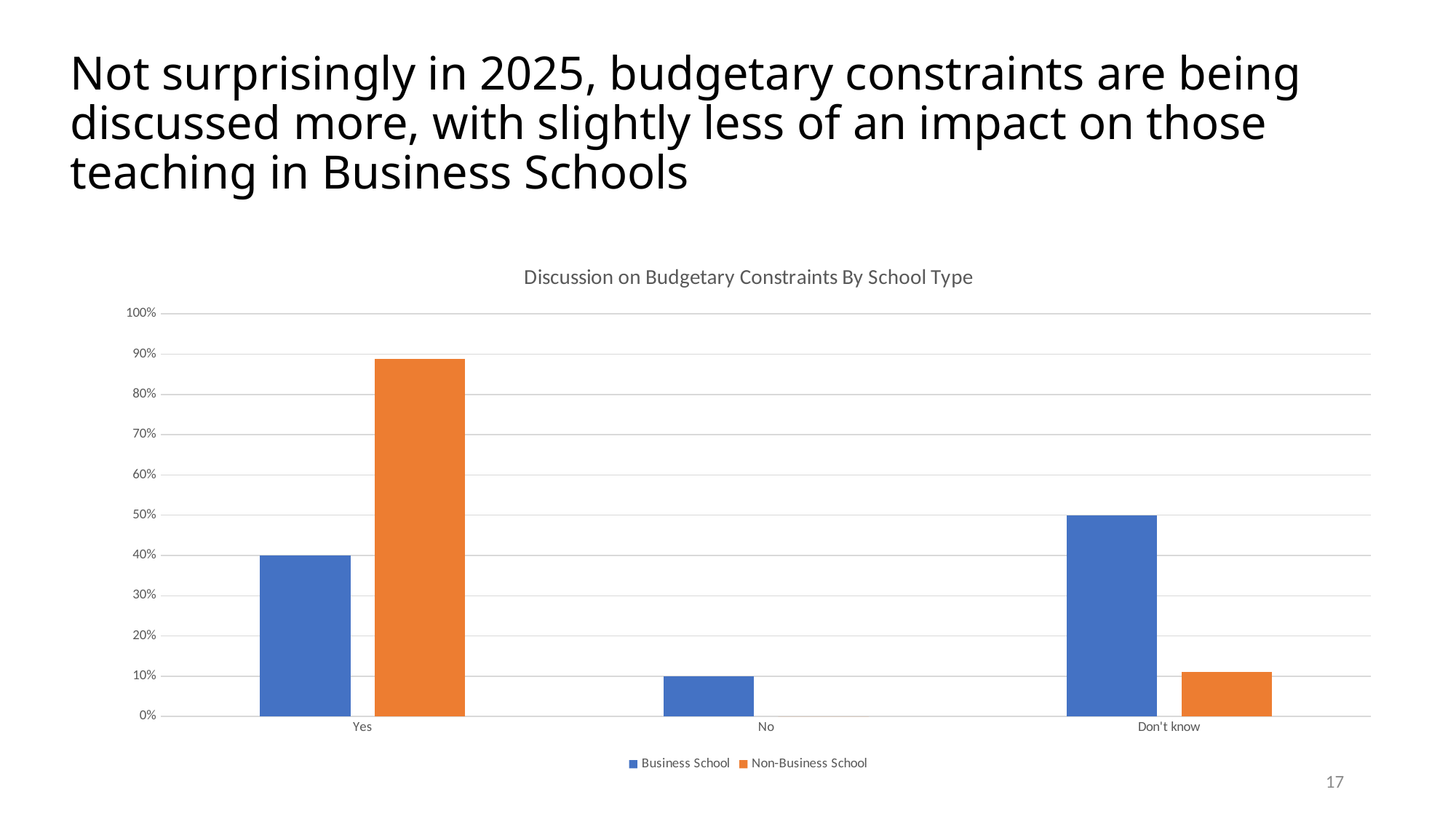
In the Don't know category, which series has the larger value, Business School or Non-Business School? Business School What is the value for Business School in the No category? 10% What is the title of the chart? Discussion on Budgetary Constraints By School Type Which category has the highest value for Non-Business School? Yes Is the value for Non-Business School in the Yes category greater or less than 80%? greater Which category has the lowest value for Business School? No What is the value for Business School in the Yes category? 40% What type of chart is shown on the slide? Bar chart Is the value for Non-Business School in the Don't know category greater or less than 20%? less How many series does the legend list? 2 What is the value for Business School in the Don't know category? 50% How many categories are shown on the x axis? 3